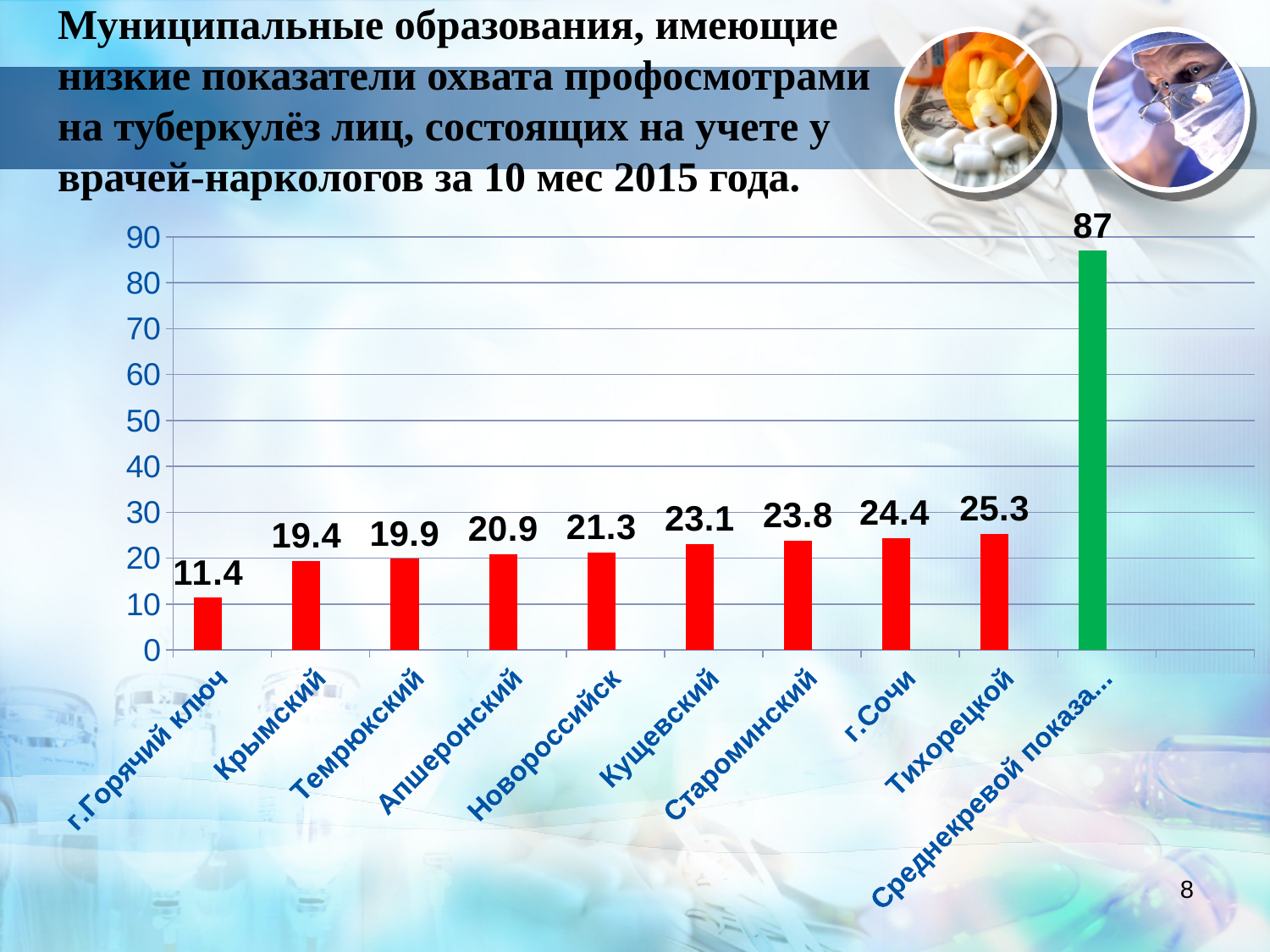
Which is larger, the value for Апшеронский or the value for Темрюкский? Апшеронский How many bars are shown in the chart? 10 What is the difference between the values for Тихорецкой and г.Горячий ключ? 13.9 What is the value for Крымский? 19.4 What colour is the bar for the highest value? Green Which category has the highest value? Среднекревой показа... What is the value for Тихорецкой? 25.3 What kind of chart is shown on the slide? Bar chart What is the difference between the values for Староминский and Кущевский? 0.7 Which category has the lowest value? г.Горячий ключ What is the value for Новороссийск? 21.3 What is the value for г.Сочи? 24.4